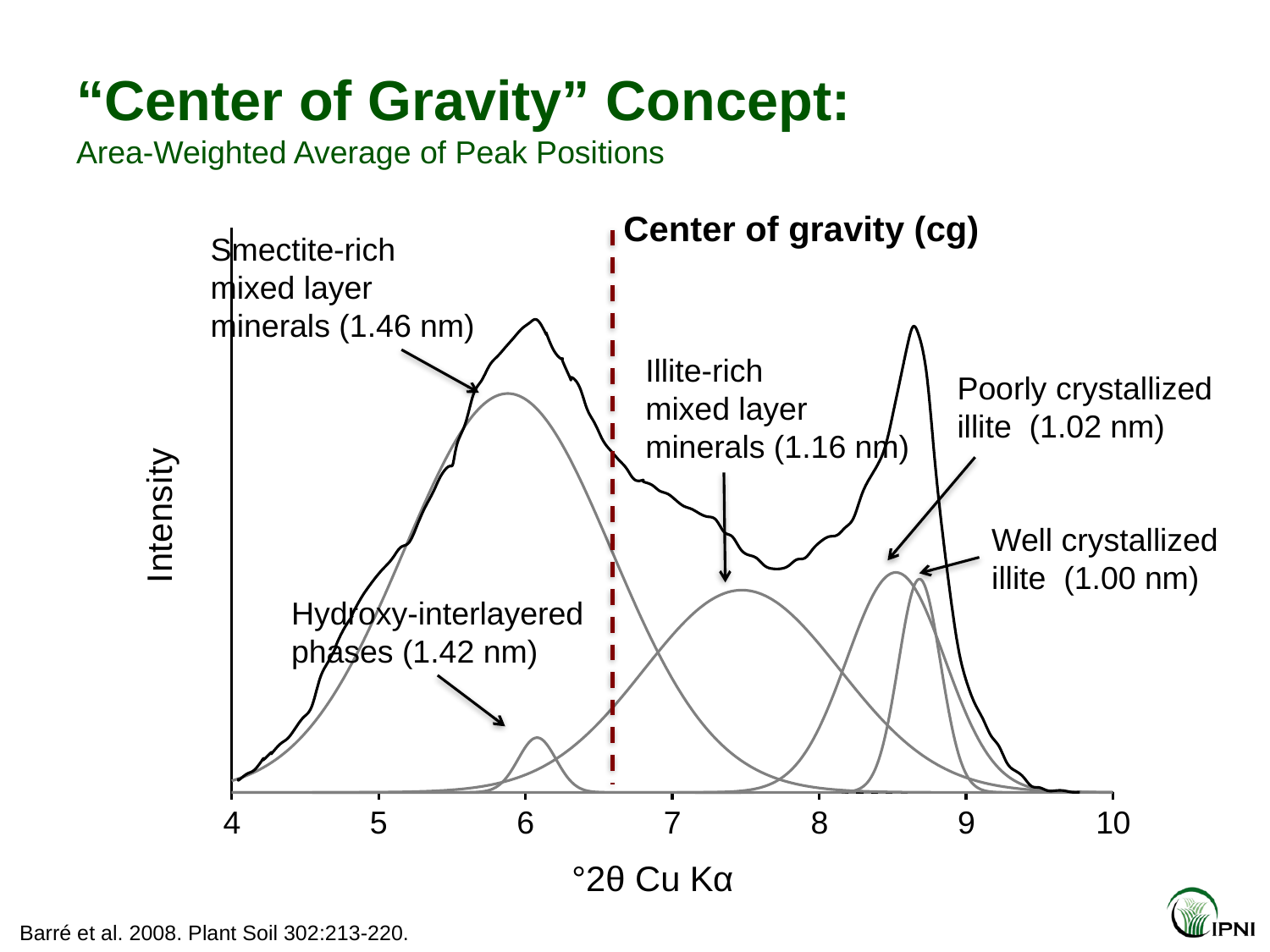
What d-spacing is given for well crystallized illite? 1.00 nm What is the label of the y axis? Intensity What d-spacing is given for the smectite-rich mixed layer minerals? 1.46 nm Which has the larger d-spacing, the smectite-rich mixed layer minerals or the hydroxy-interlayered phases? smectite-rich mixed layer minerals What d-spacing is given for the hydroxy-interlayered phases? 1.42 nm Which labeled component peak has the lowest intensity? Hydroxy-interlayered phases What d-spacing is given for the illite-rich mixed layer minerals? 1.16 nm What is the label of the x axis? °2θ Cu Kα Is the center of gravity (dashed line) at a °2θ value greater or less than 7? less What kind of chart is shown on the slide? line chart How many labeled component peaks (mineral phases) are annotated on the chart? 5 What is the difference between the d-spacing of poorly crystallized illite and well crystallized illite? 0.02 nm